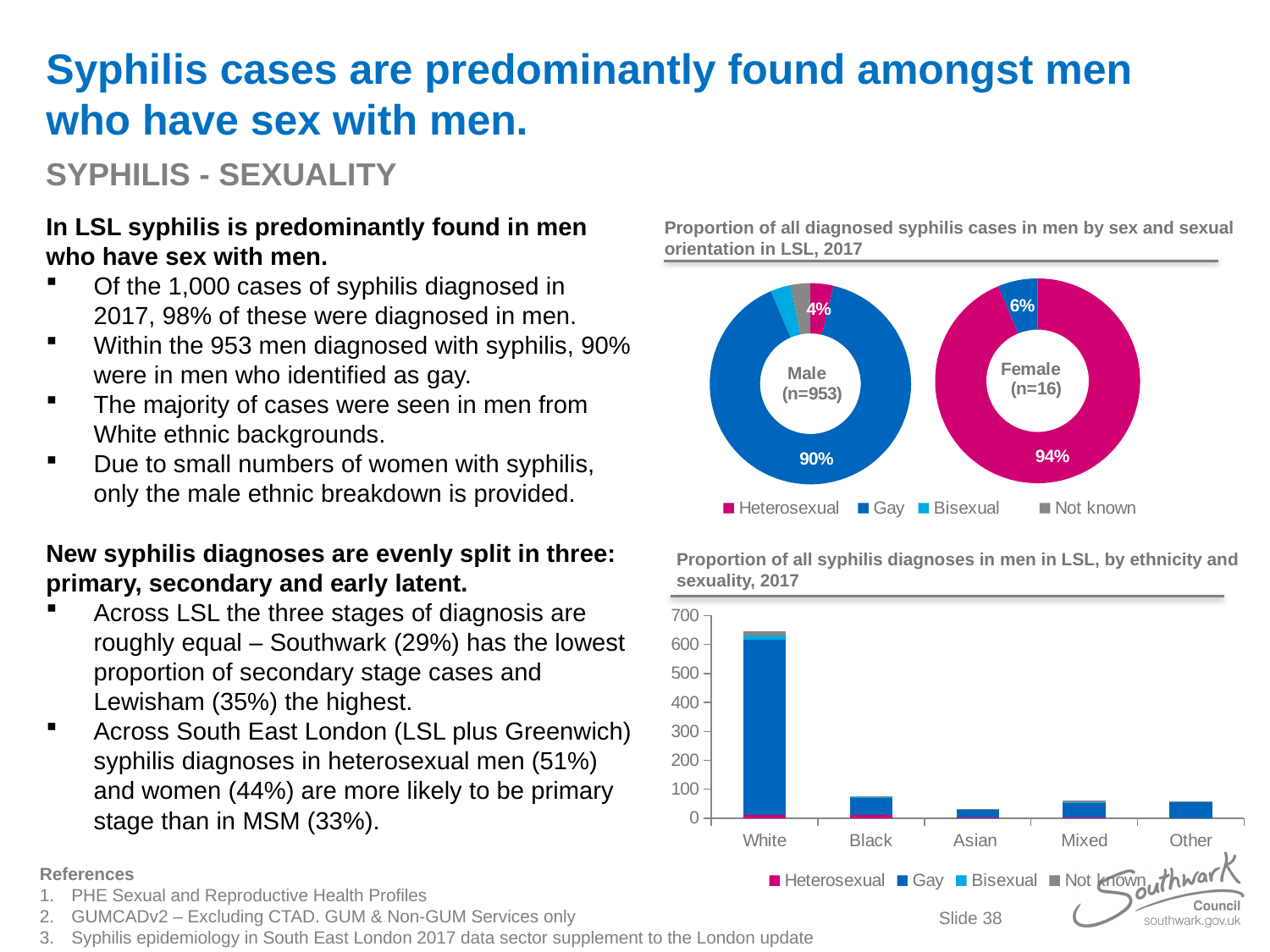
In the bar chart 'Proportion of all syphilis diagnoses in men in LSL, by ethnicity and sexuality, 2017', which ethnicity has the lowest total bar? Asian In the donut chart 'Proportion of all diagnosed syphilis cases in men by sex and sexual orientation in LSL, 2017', how many categories does the legend list? 4 In the donut chart 'Proportion of all diagnosed syphilis cases in men by sex and sexual orientation in LSL, 2017', what percentage of the Male donut is Gay? 90% In the donut chart 'Proportion of all diagnosed syphilis cases in men by sex and sexual orientation in LSL, 2017', what is the sample size (n) shown for the Male donut? n=953 In the bar chart 'Proportion of all syphilis diagnoses in men in LSL, by ethnicity and sexuality, 2017', how many ethnicity categories are shown on the x axis? 5 In the donut chart 'Proportion of all diagnosed syphilis cases in men by sex and sexual orientation in LSL, 2017', what percentage of the Male donut is Heterosexual? 4% In the bar chart 'Proportion of all syphilis diagnoses in men in LSL, by ethnicity and sexuality, 2017', which ethnicity has the highest total bar? White In the donut chart 'Proportion of all diagnosed syphilis cases in men by sex and sexual orientation in LSL, 2017', which is larger: the Gay share of the Male donut or the Heterosexual share of the Female donut? Heterosexual share of the Female donut In the donut chart 'Proportion of all diagnosed syphilis cases in men by sex and sexual orientation in LSL, 2017', what percentage of the Female donut is Heterosexual? 94% What type of chart is 'Proportion of all syphilis diagnoses in men in LSL, by ethnicity and sexuality, 2017'? Stacked bar chart In the donut chart 'Proportion of all diagnosed syphilis cases in men by sex and sexual orientation in LSL, 2017', what percentage of the Female donut is Gay? 6% In the bar chart 'Proportion of all syphilis diagnoses in men in LSL, by ethnicity and sexuality, 2017', is the total bar for White greater or less than 600? greater